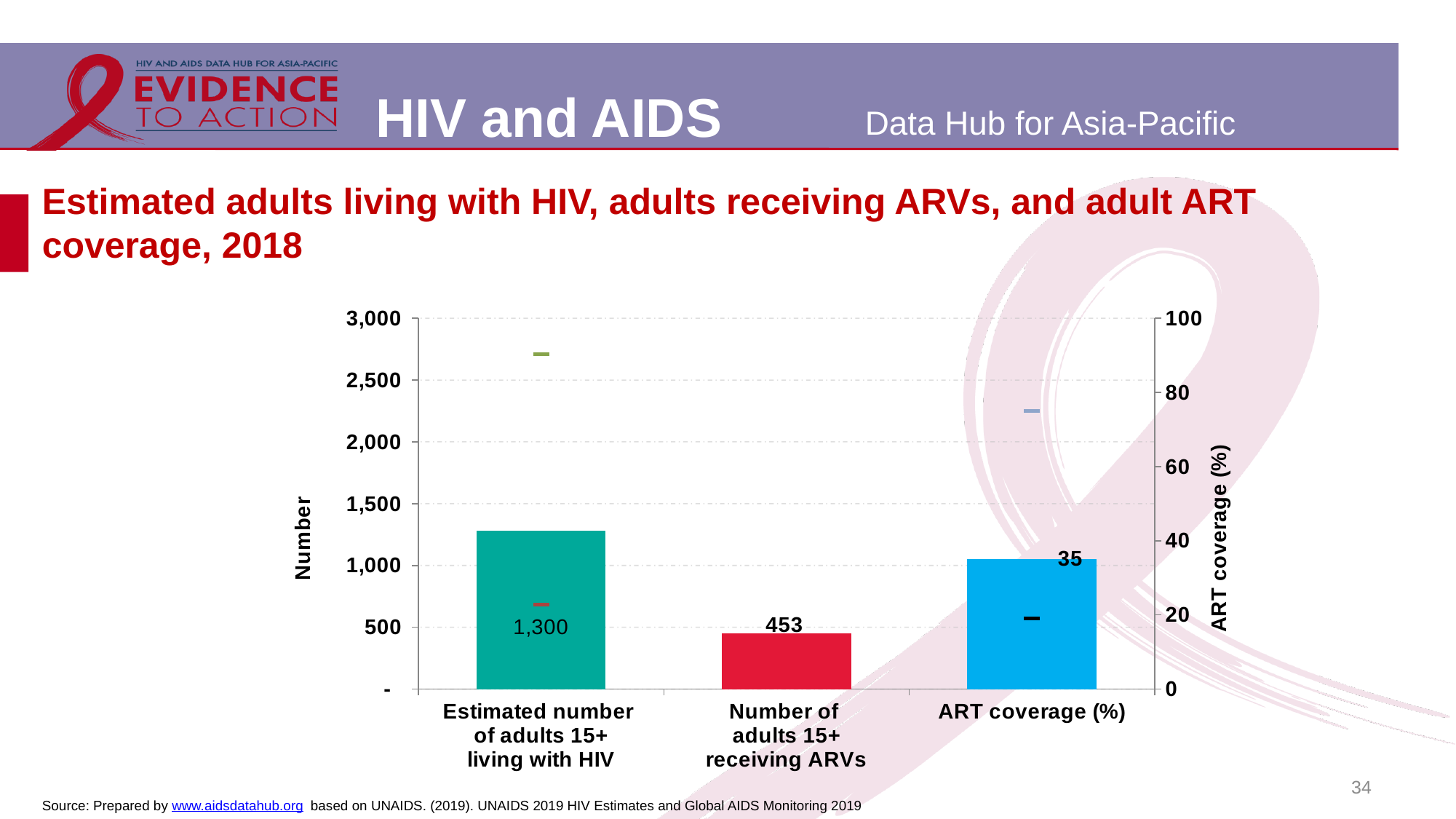
What is the title of the left vertical axis of the chart? Number What is the title of the right vertical axis of the chart? ART coverage (%) Which category has the tallest bar on the chart? Estimated number of adults 15+ living with HIV What kind of chart is shown on the slide? Bar chart What is the difference between the estimated number of adults 15+ living with HIV and the number of adults 15+ receiving ARVs? 847 How many categories are shown on the x axis of the chart? 3 What is the number of adults 15+ receiving ARVs shown on the chart? 453 What is the estimated number of adults 15+ living with HIV shown on the chart? 1,300 Is the value for the estimated number of adults 15+ living with HIV greater or less than 1,000? greater Is the value for the number of adults 15+ receiving ARVs greater or less than 500? less What is the ART coverage (%) value shown on the chart? 35 Which is larger: the estimated number of adults 15+ living with HIV or the number of adults 15+ receiving ARVs? Estimated number of adults 15+ living with HIV